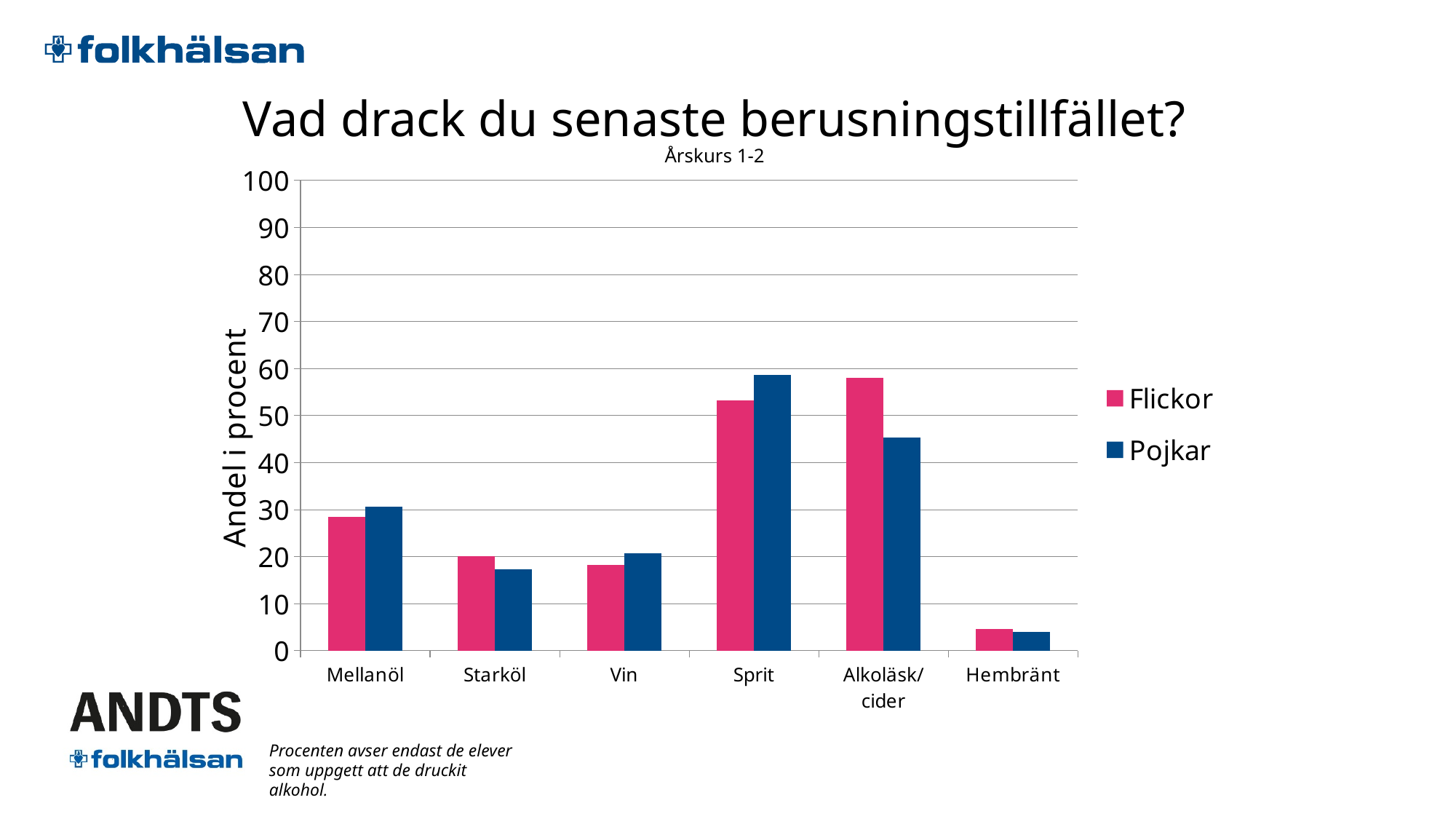
What is the label of the y axis? Andel i procent How many series does the legend list? 2 Which category has the highest value for Pojkar? Sprit For Alkoläsk/cider, which is larger, the value for Flickor or for Pojkar? Flickor Which category has the highest value for Flickor? Alkoläsk/cider Is the value for Pojkar in the Sprit category greater or less than 50? greater Is the value for Flickor in the Hembränt category greater or less than 10? less What kind of chart is shown on the slide? bar chart For Sprit, which is larger, the value for Flickor or for Pojkar? Pojkar Is the value for Pojkar in the Alkoläsk/cider category greater or less than 50? less How many drink categories are shown on the x axis? 6 Which category has the lowest value for Pojkar? Hembränt